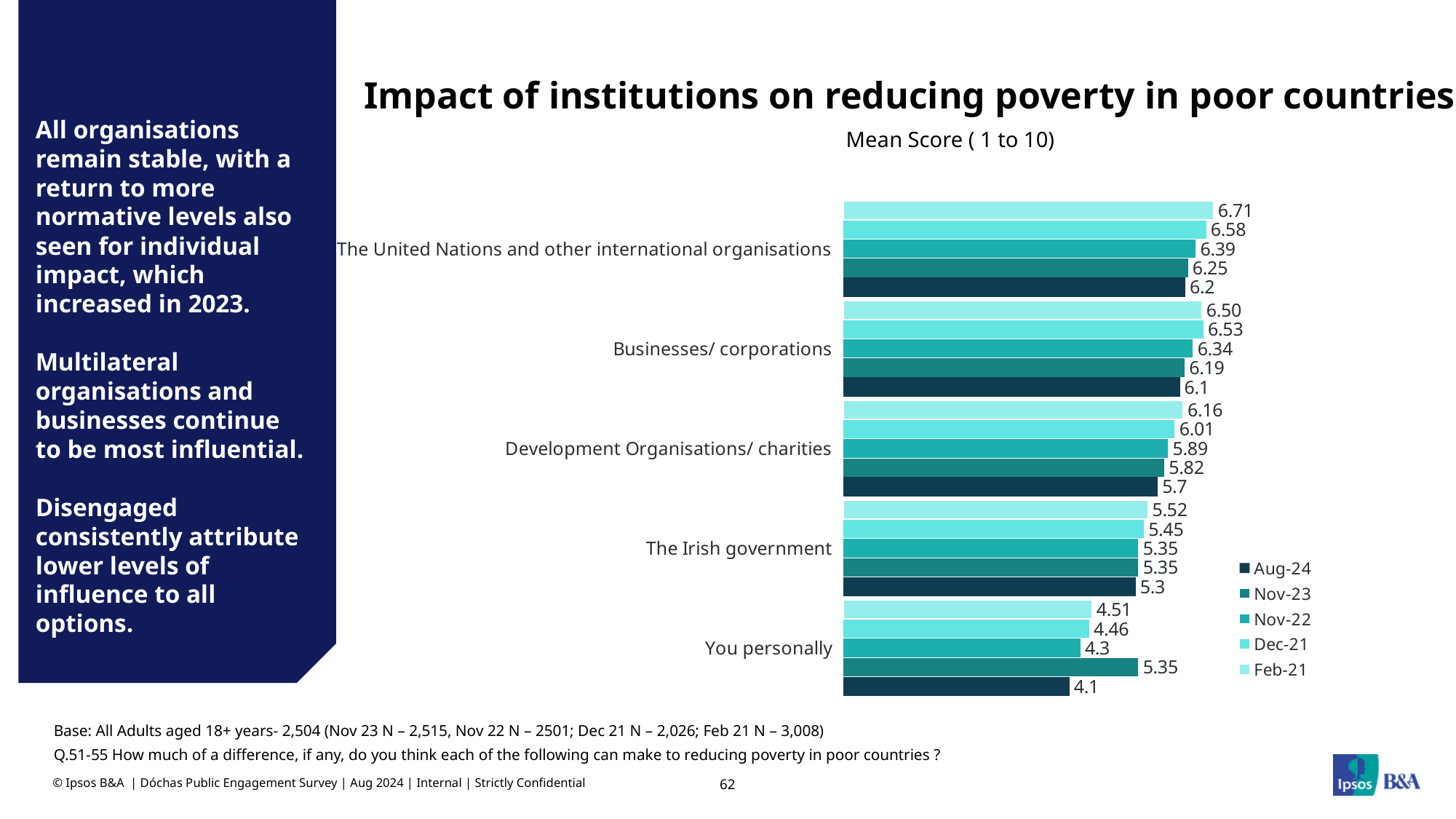
Which category has the lowest Aug-24 mean score? You personally How many categories (institutions) are shown on the chart? 5 What is the Aug-24 mean score for The United Nations and other international organisations? 6.2 What is the difference between the Nov-23 and Aug-24 mean scores for You personally? 1.25 What kind of chart is shown on the slide? bar chart What is the subtitle shown under the chart title? Mean Score ( 1 to 10) What is the Feb-21 mean score for Businesses/ corporations? 6.50 Which is larger: the Aug-24 mean score for Businesses/ corporations or for Development Organisations/ charities? Businesses/ corporations What is the Aug-24 mean score for You personally? 4.1 Which category has the highest Feb-21 mean score? The United Nations and other international organisations How many series does the legend list? 5 What is the Nov-23 mean score for You personally? 5.35